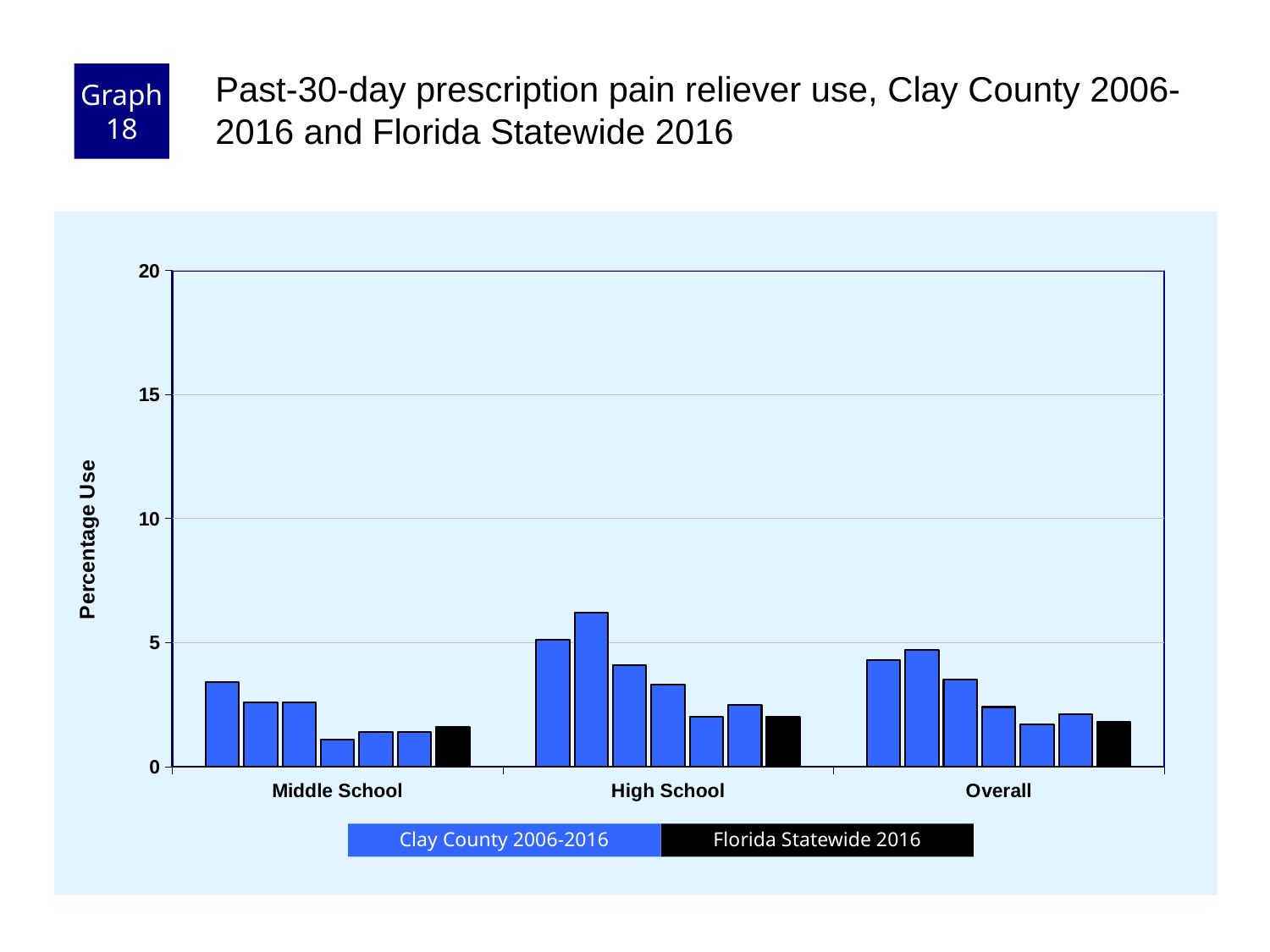
Is the tallest Clay County 2006-2016 bar for Middle School greater or less than 5? less How many categories are shown on the x axis of the chart? 3 Which is larger: the Florida Statewide 2016 bar for High School or the tallest Clay County 2006-2016 bar for High School? Clay County 2006-2016 Which category has the tallest bar in the chart? High School How many series does the chart's legend list? 2 What is the label on the y axis of the chart? Percentage Use Which series is shown in black in the chart's legend? Florida Statewide 2016 Which is larger: the tallest Clay County 2006-2016 bar for High School or the tallest Clay County 2006-2016 bar for Middle School? High School Is the Florida Statewide 2016 value for Overall greater or less than 5? less What kind of chart is shown on the slide? bar chart Is the Florida Statewide 2016 value for High School greater or less than 5? less